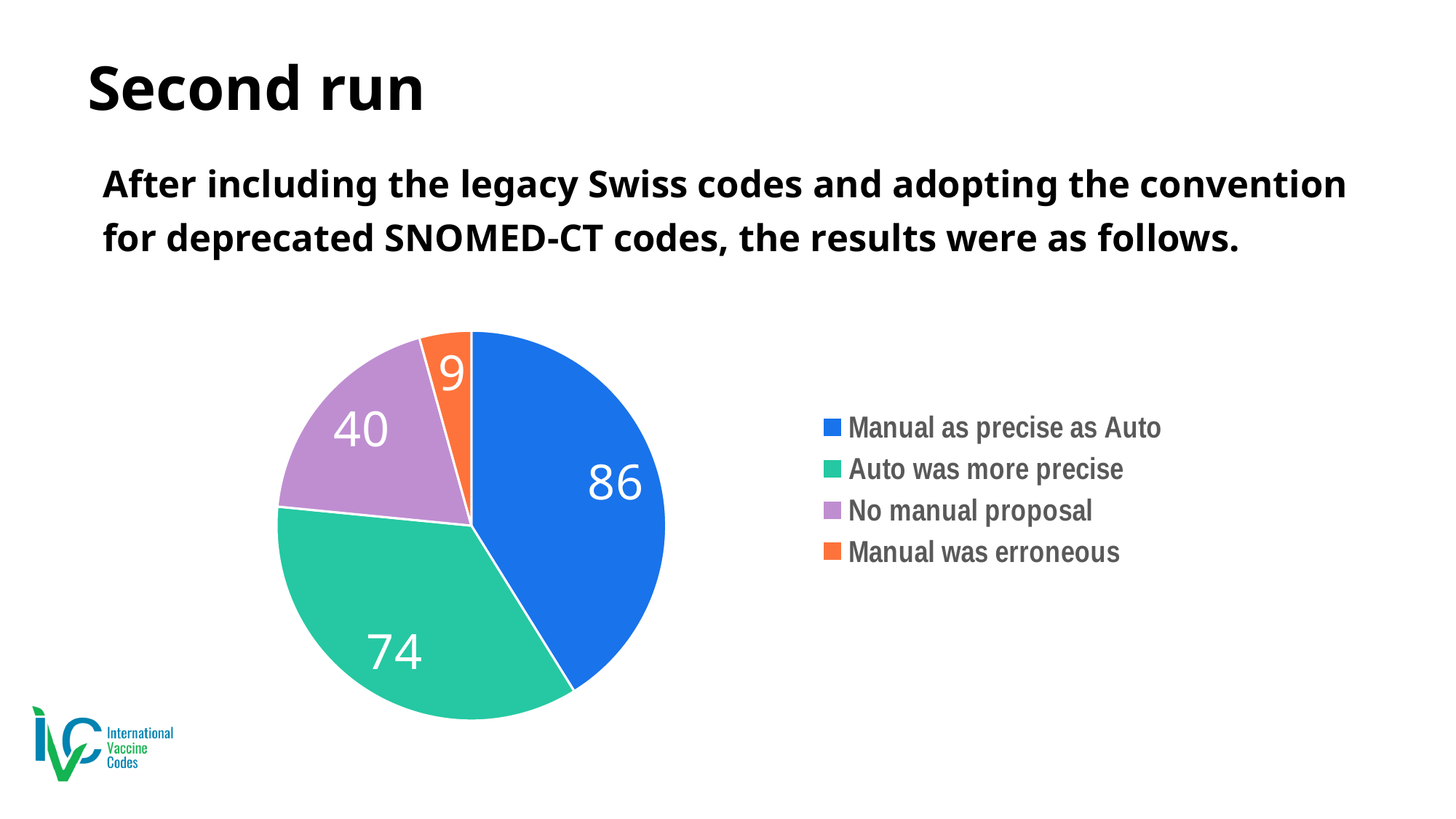
Which is larger: "No manual proposal" or "Manual was erroneous"? No manual proposal What is the total of all the slices in the pie chart? 209 What is the difference between the values for "Manual as precise as Auto" and "Auto was more precise"? 12 What kind of chart is shown on the slide? Pie chart What is the value for "Manual was erroneous"? 9 How many categories does the pie chart have? 4 Which category has the smallest slice of the pie? Manual was erroneous What is the value for "Auto was more precise"? 74 What is the value for "No manual proposal"? 40 Which category has the largest slice of the pie? Manual as precise as Auto What colour is the slice for "Auto was more precise"? Green What is the value for "Manual as precise as Auto"? 86